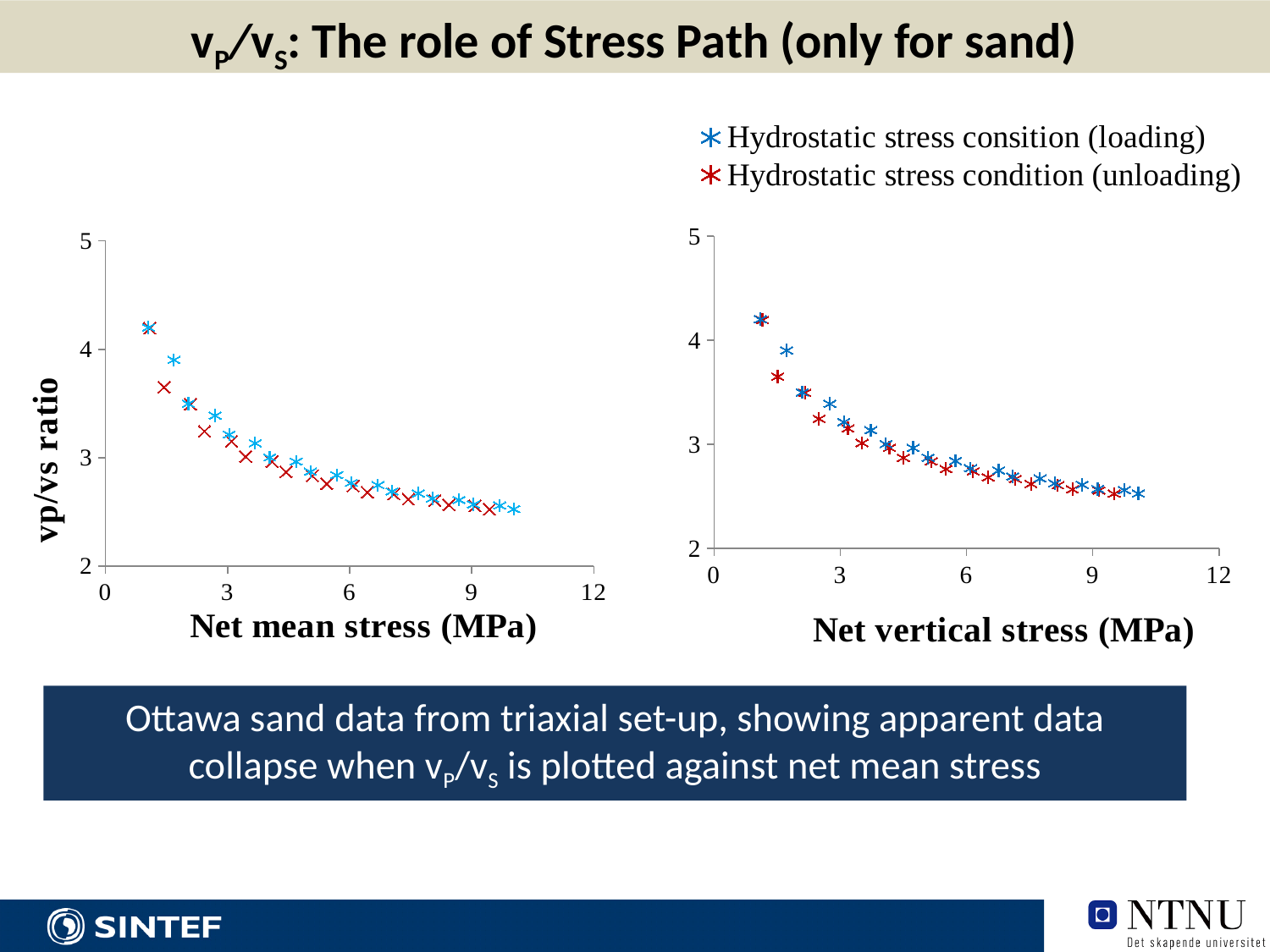
What kind of chart is the right chart, with x-axis 'Net vertical stress (MPa)'? scatter chart What is the label of the y-axis on the left chart? vp/vs ratio How many series does the legend list? 2 In the right chart (Net vertical stress), is the vp/vs ratio of the loading series at a net vertical stress of about 9 greater or less than 3? less Which legend entry is shown in red? Hydrostatic stress condition (unloading) In the left chart (Net mean stress), is the vp/vs ratio of the loading series at the lowest net mean stress greater or less than 4? greater In the left chart (Net mean stress), is the vp/vs ratio of the unloading series at a net mean stress of about 6 greater or less than 3? less What kind of chart is the left chart, with x-axis 'Net mean stress (MPa)'? scatter chart In the right chart (Net vertical stress), do the vp/vs ratio values rise or fall as net vertical stress increases? fall In the left chart (Net mean stress), do the vp/vs ratio values rise or fall as net mean stress increases? fall